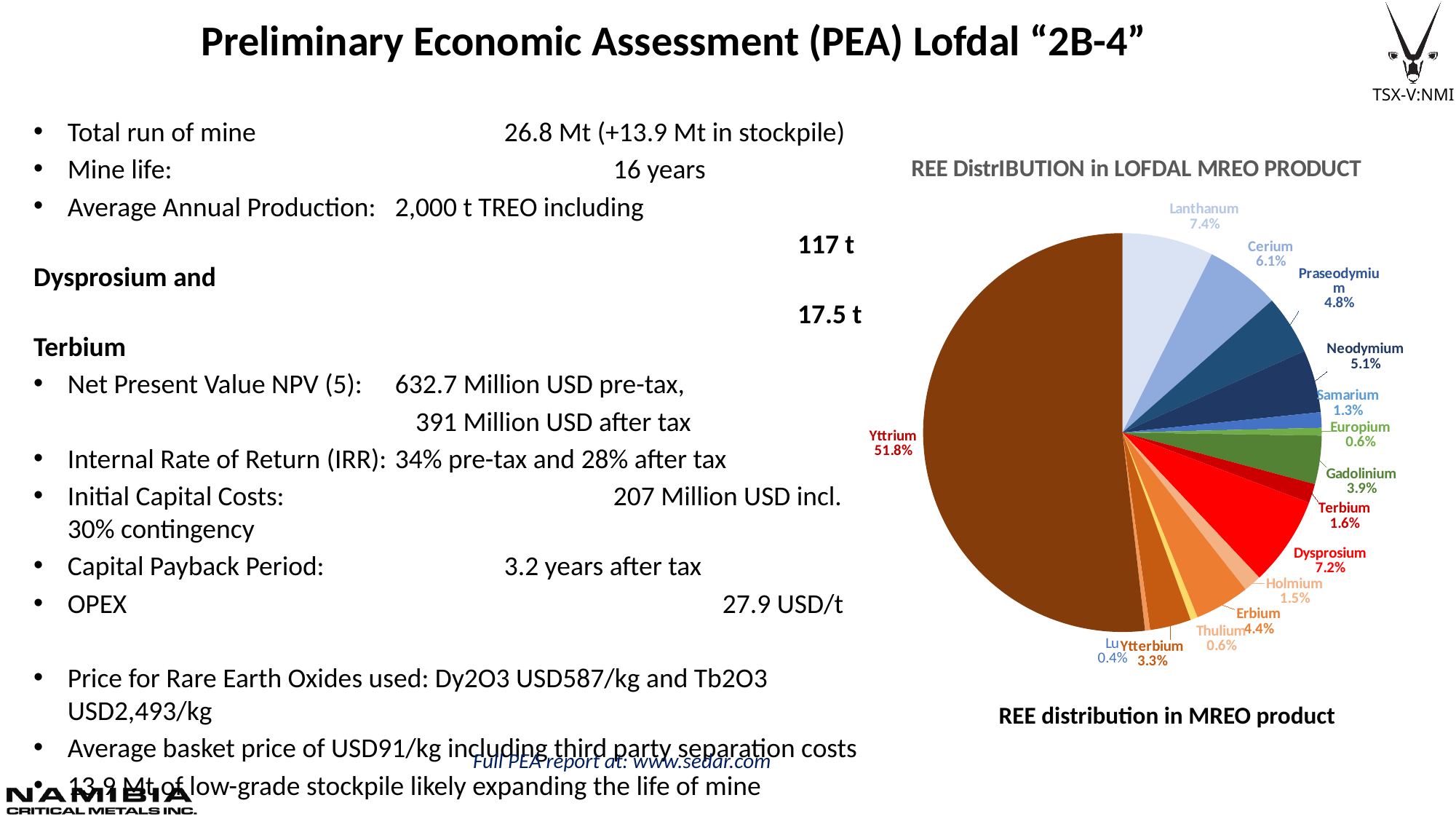
What is the difference in percentage points between Lanthanum and Dysprosium in the pie chart? 0.2 Which has a larger share in the pie chart, Cerium or Neodymium? Cerium What share of the REE distribution in Lofdal MREO product is Yttrium? 51.8% How many slices does the pie chart have? 15 Which element has the largest slice in the pie chart? Yttrium What is the title of the pie chart? REE DistrIBUTION in LOFDAL MREO PRODUCT What percentage of the pie chart is Dysprosium? 7.2% What type of chart is shown on the slide? pie chart Which element has the smallest slice in the pie chart? Lu What is the share of Lanthanum in the pie chart? 7.4% What is the combined share of Dysprosium and Terbium in the pie chart? 8.8% What percentage does Terbium represent in the REE distribution pie chart? 1.6%